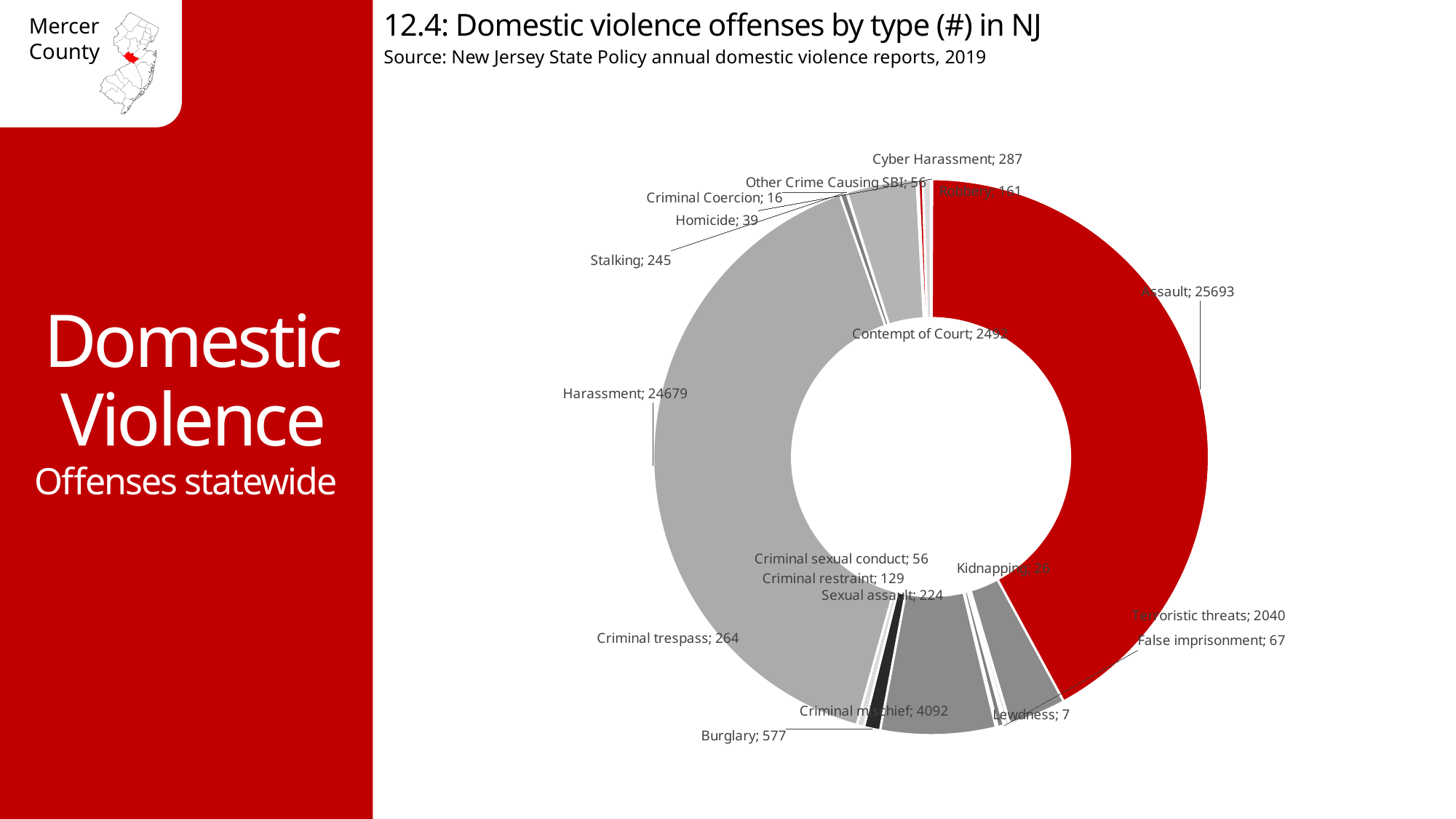
Which offense type has the lowest number of offenses? Lewdness What is the number of Assault offenses shown on the chart? 25693 Which is larger, Stalking or Cyber Harassment? Cyber Harassment What is the difference between the Criminal mischief and Terroristic threats values? 2052 What value is shown for Terroristic threats? 2040 Which offense type has the highest number of offenses? Assault What is the number of Harassment offenses shown on the chart? 24679 What is the title of the chart? 12.4: Domestic violence offenses by type (#) in NJ What value is shown for Criminal mischief? 4092 What kind of chart is shown on the slide? doughnut chart What is the difference between the Assault and Harassment values? 1014 What value is shown for Burglary? 577